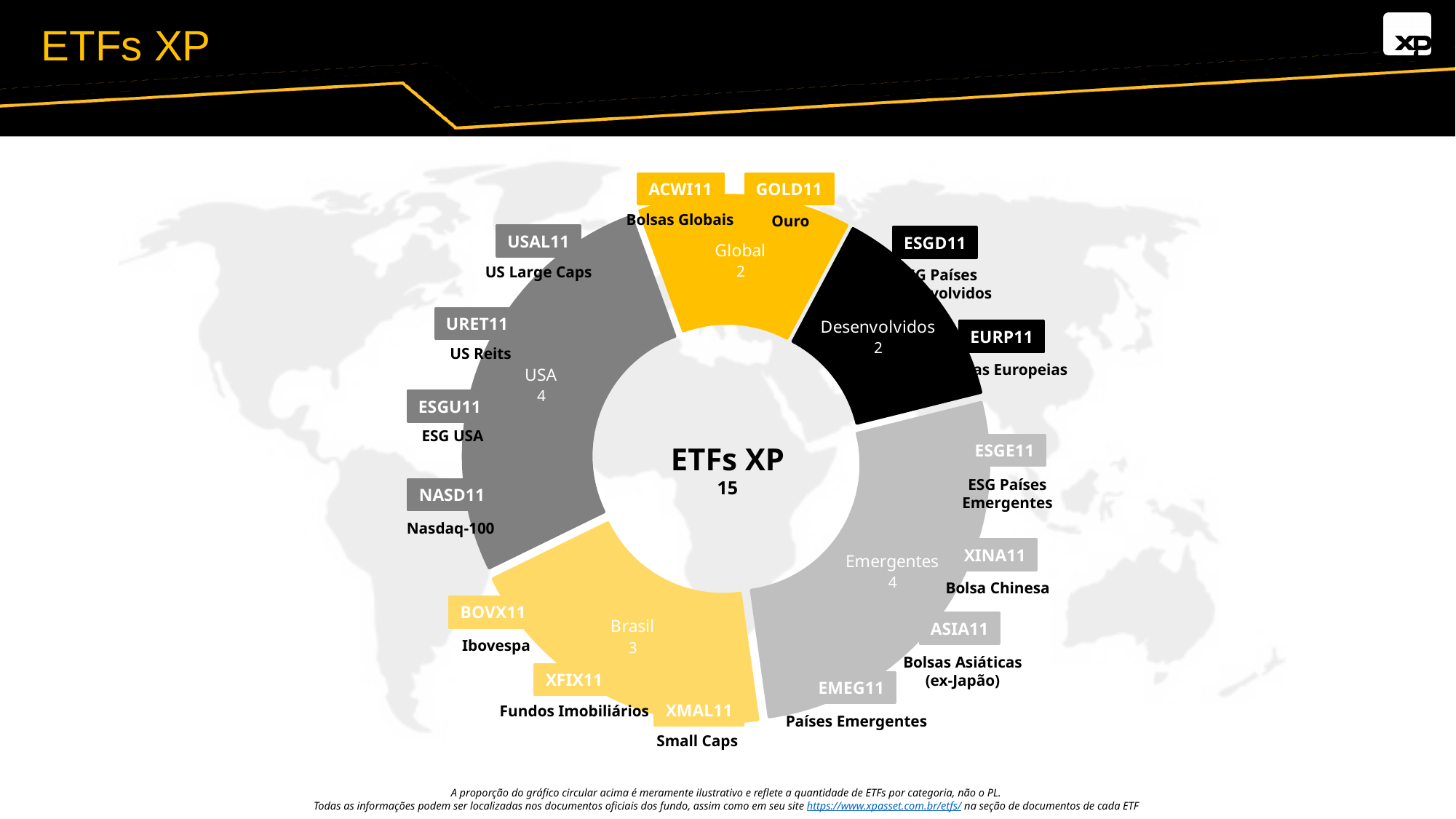
How many categories does the donut chart have? 5 What kind of chart is shown on the slide? Donut (pie) chart How many ETFs does the chart show for the USA category? 4 How many ETFs does the chart show for the Emergentes category? 4 What is the difference between the number of ETFs in USA and in Brasil? 1 What share of the 15 ETFs does the Brasil category represent? 20% How many ETFs does the chart show for the Desenvolvidos category? 2 Which has more ETFs, USA or Brasil? USA How many ETFs does the chart show for the Global category? 2 What is the total number of ETFs shown in the centre of the chart? 15 How many ETFs does the chart show for the Brasil category? 3 What is the title shown in the centre of the donut chart? ETFs XP